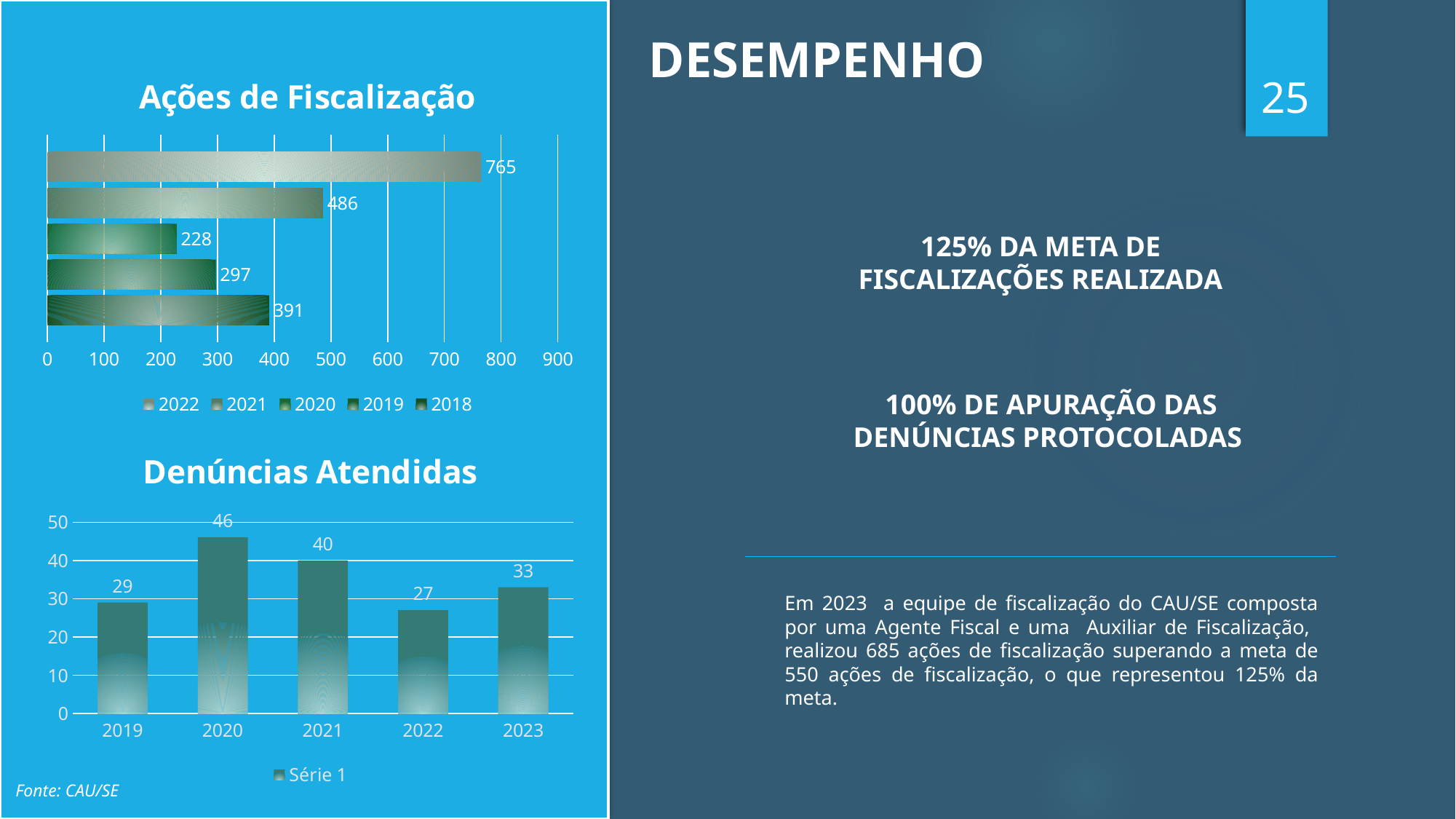
In the 'Ações de Fiscalização' chart, what is the value of the shortest bar? 228 In the 'Ações de Fiscalização' chart, what is the value of the longest bar? 765 In the 'Denúncias Atendidas' chart, which is larger, the value for 2022 or the value for 2023? 2023 How many years are shown on the x axis of the 'Denúncias Atendidas' chart? 5 In the 'Denúncias Atendidas' chart, what is the value for 2020? 46 In the 'Denúncias Atendidas' chart, what is the value for 2023? 33 How many entries does the legend of the 'Ações de Fiscalização' chart list? 5 What is the name of the series in the legend of the 'Denúncias Atendidas' chart? Série 1 In the 'Denúncias Atendidas' chart, which year has the highest value? 2020 In the 'Denúncias Atendidas' chart, which year has the lowest value? 2022 In the 'Denúncias Atendidas' chart, what is the difference between the values for 2021 and 2019? 11 What kind of chart is 'Denúncias Atendidas'? Bar chart